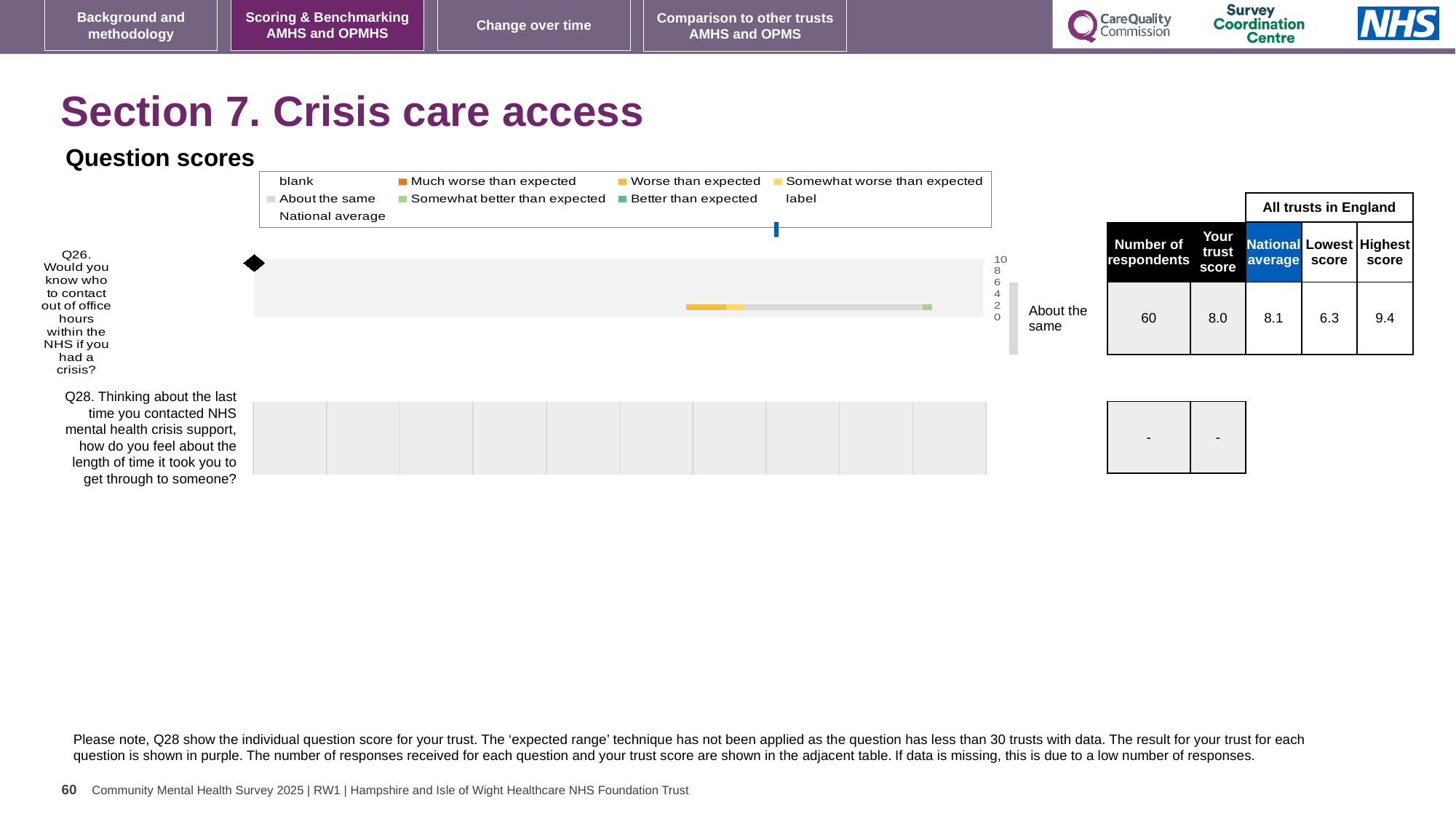
What type of chart is used to show the question scores? Bar chart What is the difference between the national average and the trust score for Q26? 0.1 What is the highest score among all trusts in England for Q26? 9.4 Which is larger for Q26: the trust score or the national average? National average What is the difference between the highest score and the lowest score for Q26? 3.1 How is the trust's result for Q26 categorised relative to the expected range? About the same What is the national average score for Q26? 8.1 What is the trust score for Q26 (Would you know who to contact out of office hours within the NHS if you had a crisis?)? 8.0 What is shown as the trust score for Q28? - What is the lowest score among all trusts in England for Q26? 6.3 How many respondents answered Q26? 60 How many questions are plotted on the chart? 2